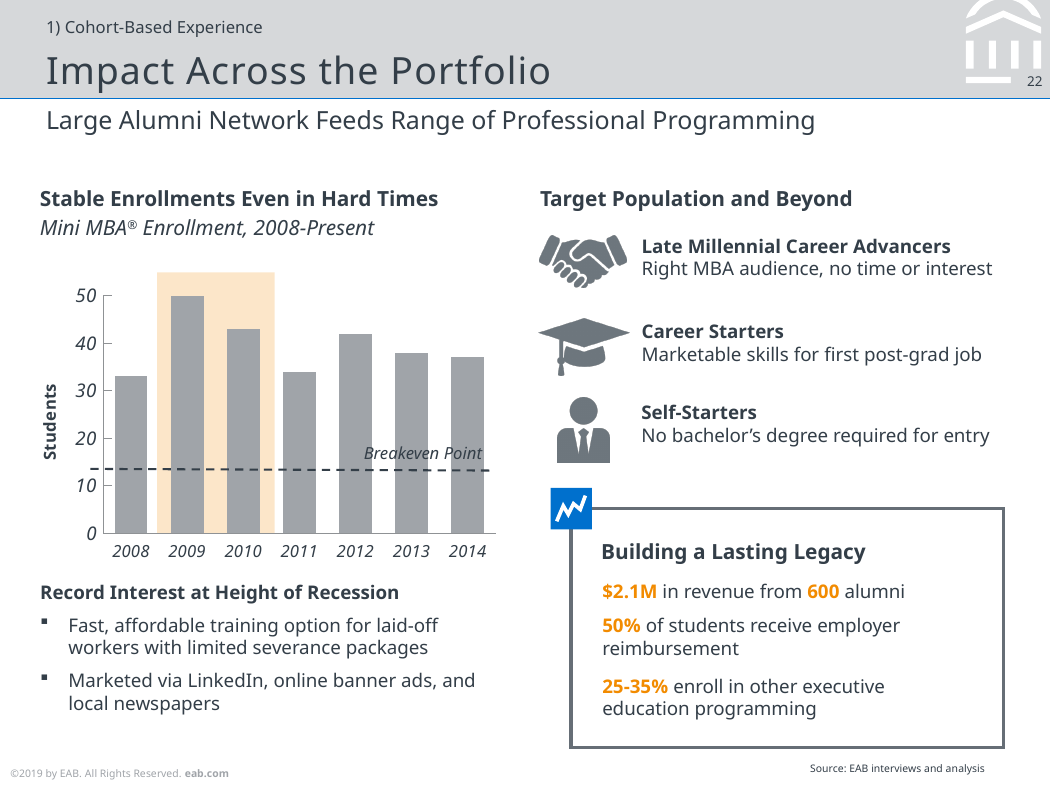
Which year has higher enrollment, 2009 or 2010? 2009 What kind of chart is shown under "Mini MBA Enrollment, 2008-Present"? bar chart Is the enrollment value for 2009 greater or less than 40? greater What does the dashed horizontal line on the Mini MBA Enrollment chart represent? Breakeven Point Is the enrollment value for 2011 greater or less than 40? less How many years are plotted on the Mini MBA Enrollment chart? 7 Is the enrollment value for 2008 greater or less than 40? less Which year has higher enrollment, 2011 or 2012? 2012 Which year has the highest enrollment on the Mini MBA Enrollment chart? 2009 What is the label on the vertical axis of the Mini MBA Enrollment chart? Students